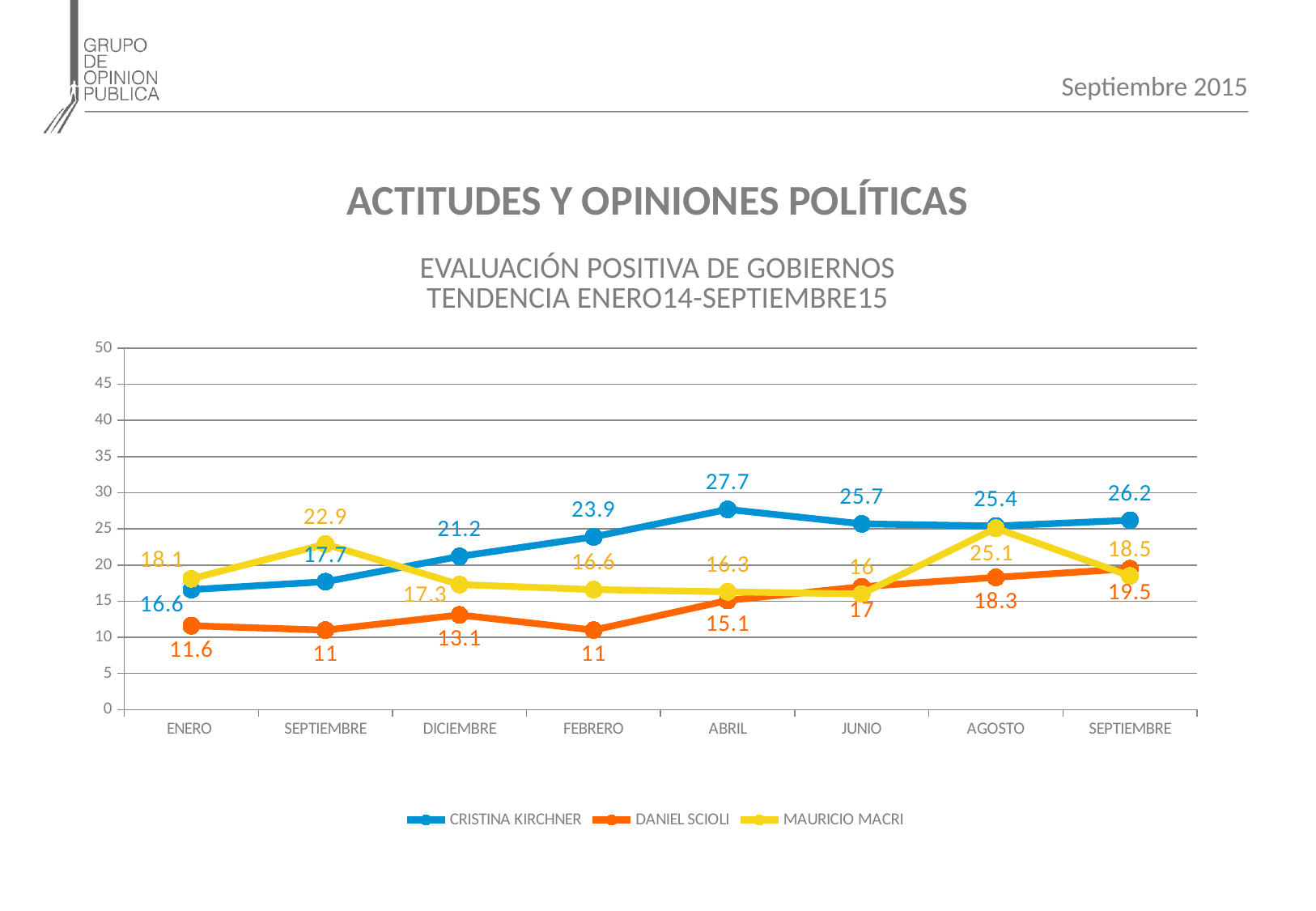
How many points along the x axis does each line have? 8 What is the value for Cristina Kirchner in Abril? 27.7 What colour is the line for Daniel Scioli? orange How many series does the legend list? 3 What is the value for Mauricio Macri in Diciembre? 17.3 What is the difference between Cristina Kirchner and Daniel Scioli in Abril? 12.6 In which month does Cristina Kirchner reach her highest value? Abril In Enero, who has the higher value, Mauricio Macri or Cristina Kirchner? Mauricio Macri What kind of chart is shown on the slide? line chart What is the value for Daniel Scioli in Agosto? 18.3 In which month does Mauricio Macri reach his highest value? Agosto Does Daniel Scioli's line rise or fall from Abril to the final Septiembre? rise